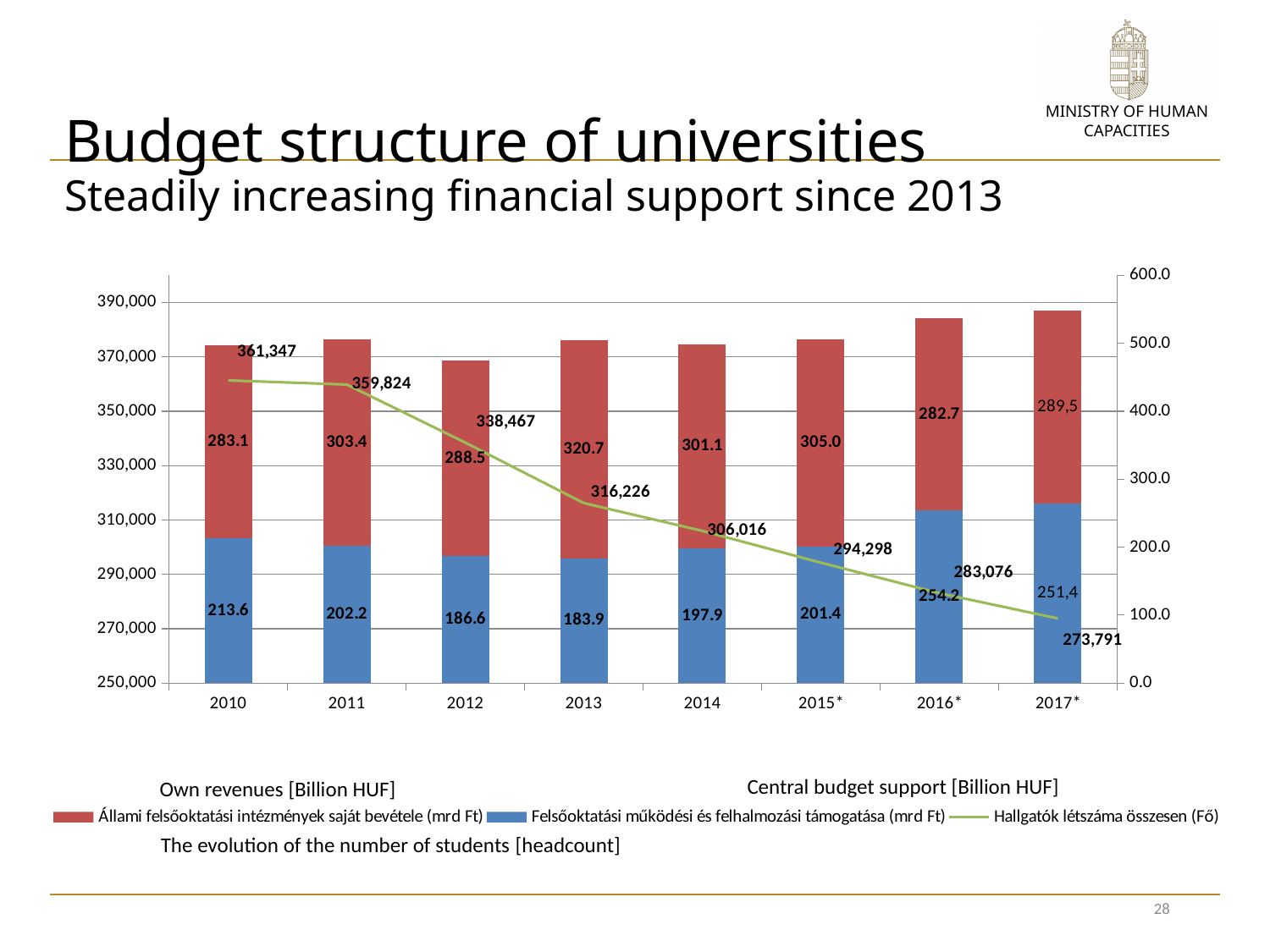
What is the total of the stacked bar for 2010 (own revenues plus central budget support)? 496.7 What is the central budget support value for 2013? 183.9 How many series does the legend list? 3 Which year has the lowest central budget support value? 2013 Is the own revenues value for 2015* larger or smaller than the value for 2014? larger Which year has the highest own revenues value? 2013 Does the number of students line rise or fall from 2010 to 2017*? fall How many years are shown on the x axis? 8 What is the difference between the own revenues value for 2013 and for 2010? 37.6 What is the number of students shown for 2014? 306,016 What is the own revenues value for 2011? 303.4